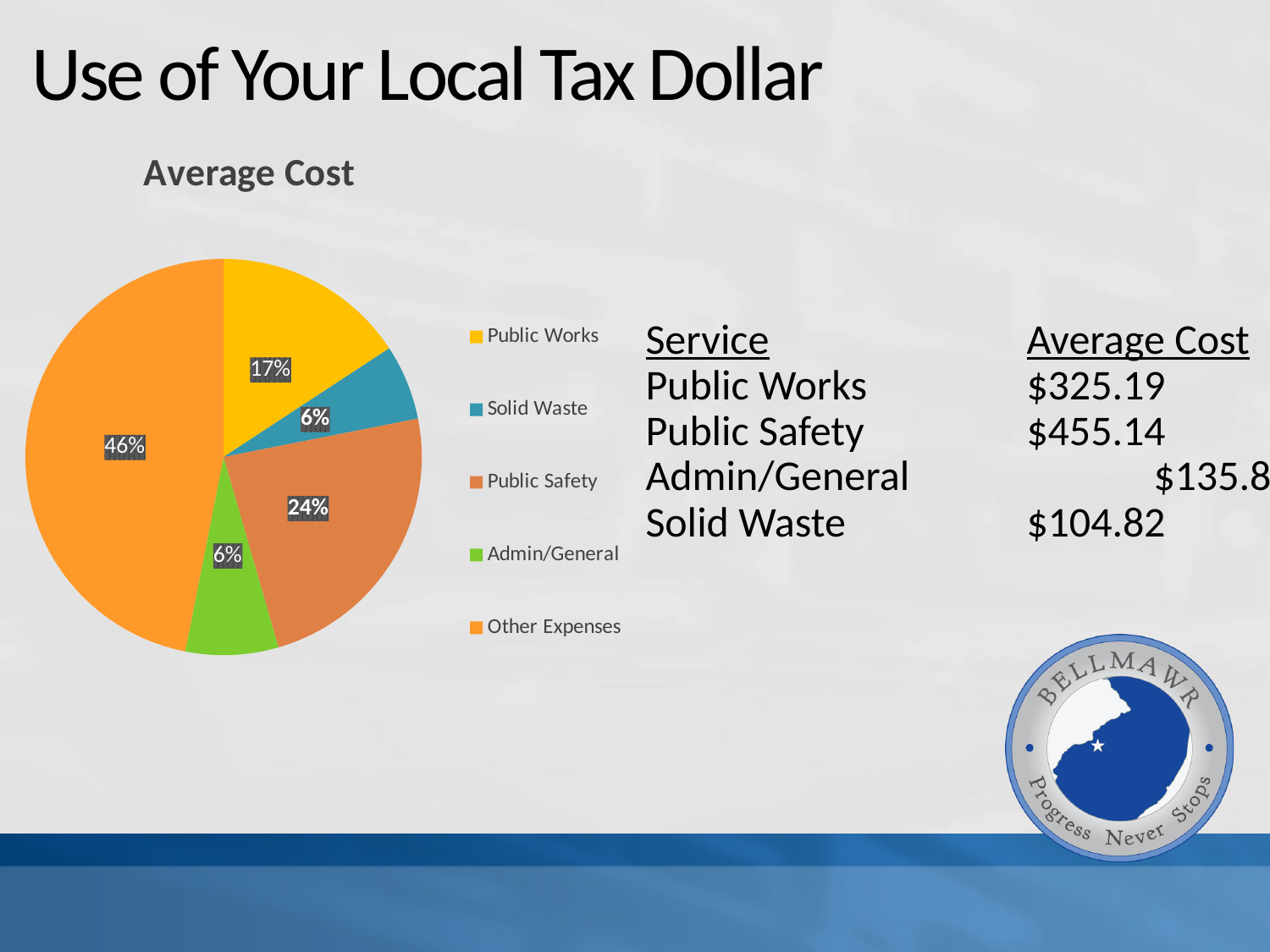
What kind of chart is shown on the slide? pie chart Which legend entry is shown in green? Admin/General What share of the pie does Admin/General represent? 6% What share of the pie does Public Safety represent? 24% What is the title of the chart? Average Cost How many categories does the legend list? 5 Which slice is larger, Solid Waste or Public Works? Public Works Which category has the largest slice of the pie? Other Expenses Which slice is larger, Public Works or Public Safety? Public Safety What is the difference in percentage points between the Other Expenses slice and the Public Safety slice? 22% What share of the pie does Public Works represent? 17%